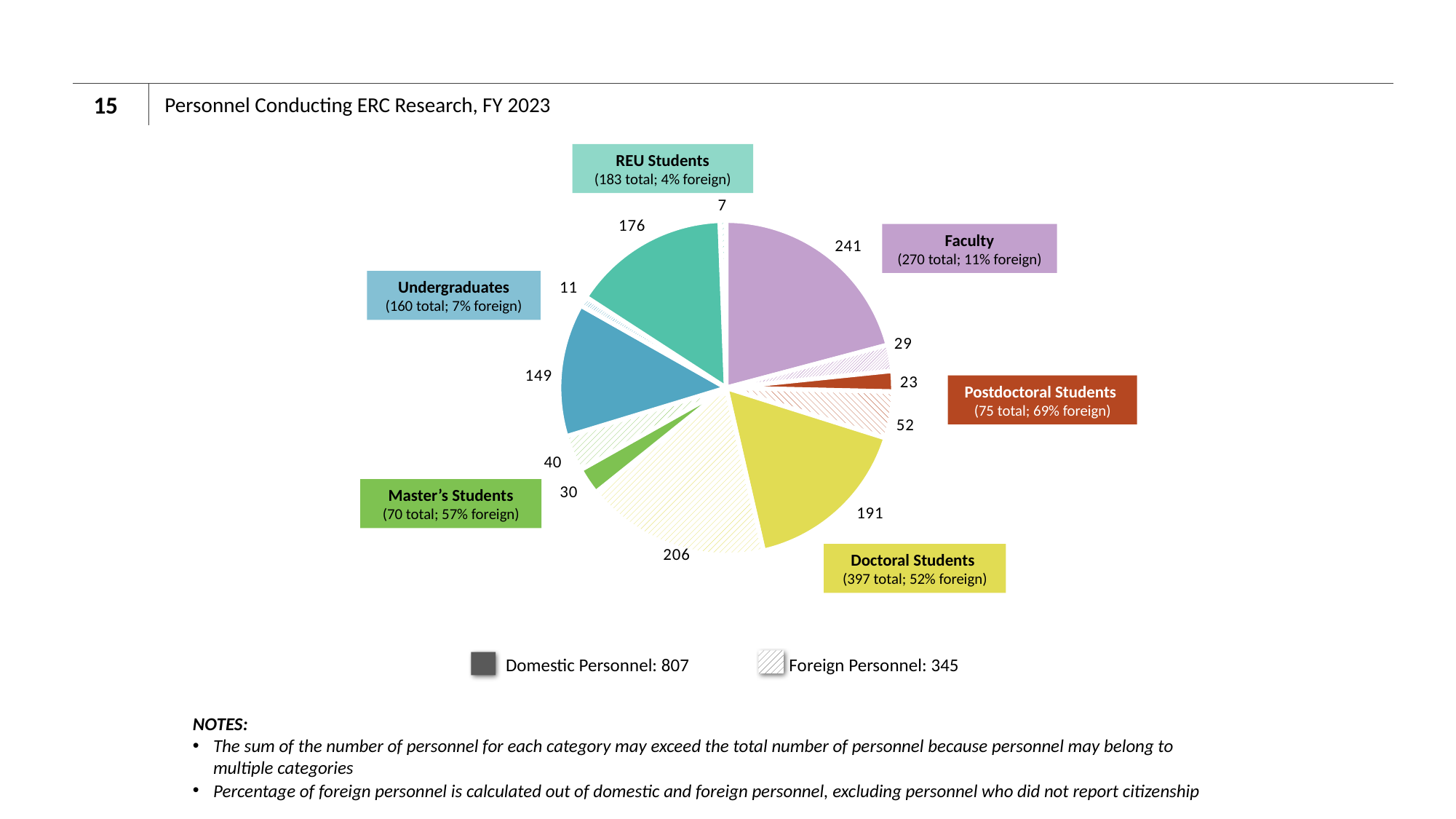
How many personnel categories are labelled in the pie chart? 6 What percentage of Postdoctoral Students are foreign, according to the chart's label box? 69% foreign What is the total number of Doctoral Students given in the chart's label box? 397 total Which is larger: the number of foreign Postdoctoral Students or the number of foreign Master's Students? foreign Postdoctoral Students What kind of chart is shown on the slide? pie chart How many foreign REU Students are shown in the pie chart? 7 How many domestic Undergraduates are shown in the pie chart? 149 Which personnel category has the smallest total number of personnel? Master's Students How many domestic Faculty personnel are shown in the pie chart? 241 What is the difference between the number of domestic Faculty (241) and domestic REU Students (176)? 65 Which personnel category has the largest total number of personnel? Doctoral Students How many foreign Doctoral Students are shown in the pie chart? 206